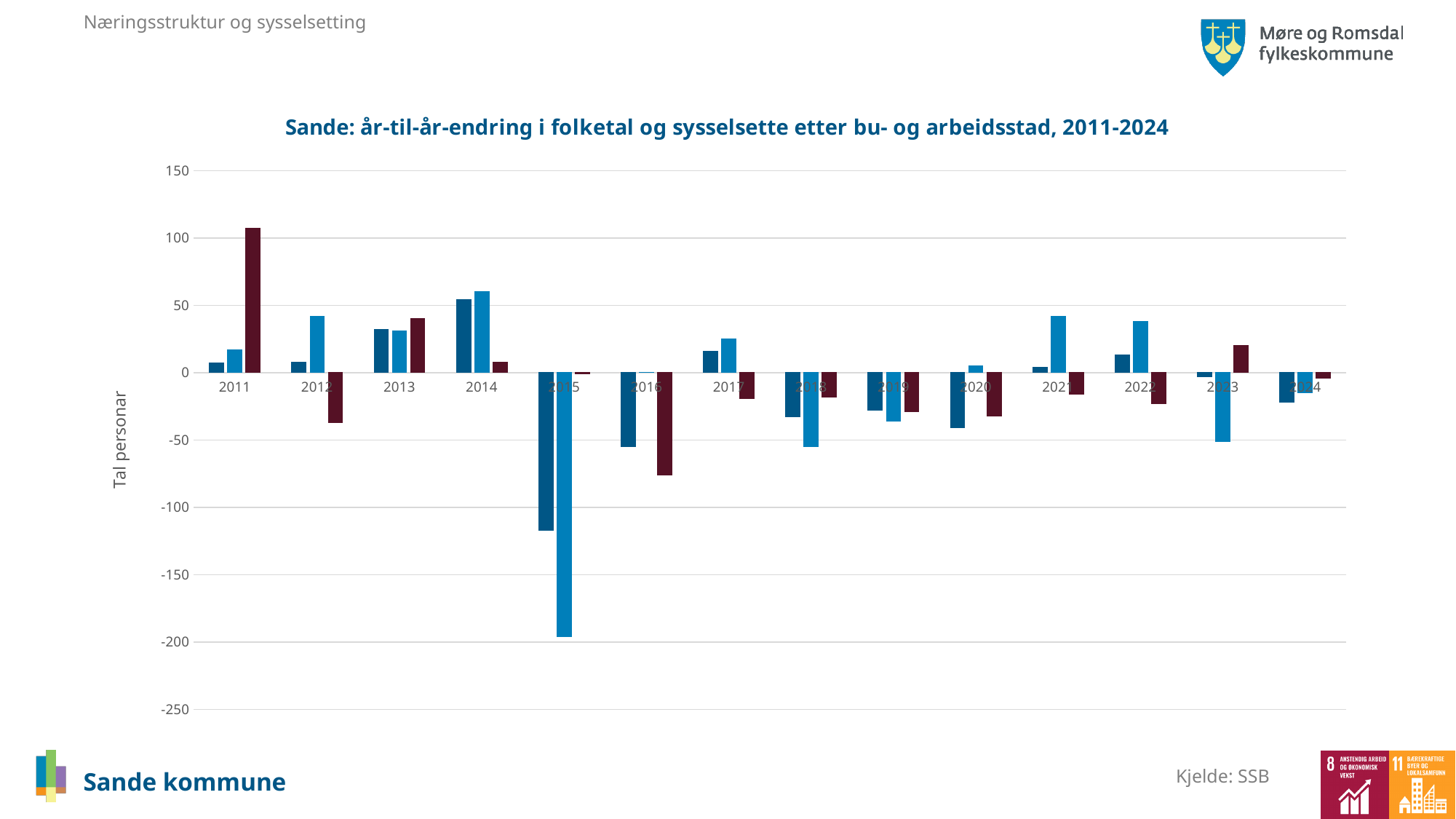
What is the label on the vertical axis of the chart? Tal personar Is the value of the dark red bar for 2011 greater or less than 100? greater In which year is the light blue bar lowest? 2015 Is the value of the dark blue bar for 2015 greater or less than -100? less Which is larger: the dark red bar for 2011 or the light blue bar for 2014? the dark red bar for 2011 Is the value of the light blue bar for 2014 greater or less than 50? greater How many years are shown along the x axis of the chart? 14 In which year is the dark red bar highest? 2011 What kind of chart is shown on the slide? bar chart What is the title of the chart? Sande: år-til-år-endring i folketal og sysselsette etter bu- og arbeidsstad, 2011-2024